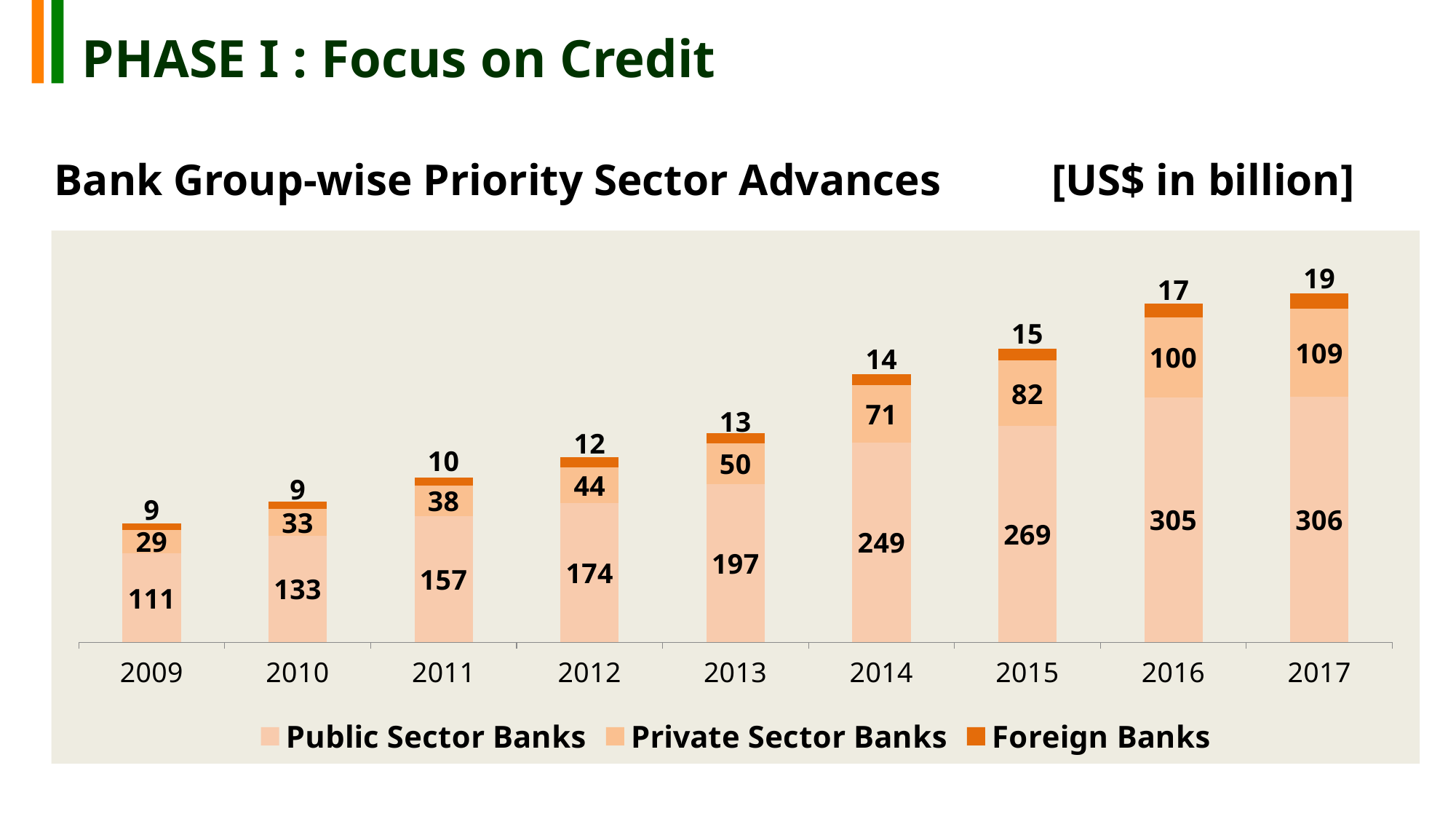
What is the total of the stacked bar for 2009? 149 What kind of chart is shown on the slide? Stacked bar chart What is the difference between the Public Sector Banks values for 2016 and 2009? 194 In which year is the Private Sector Banks value lowest? 2009 Which is larger, the Private Sector Banks value in 2015 or in 2013? 2015 How many series does the legend list? 3 In which year is the Public Sector Banks value highest? 2017 What is the value for Public Sector Banks in 2014? 249 What is the total of the stacked bar for 2017? 434 What is the value for Private Sector Banks in 2012? 44 How many years are shown on the x axis? 9 What is the value for Foreign Banks in 2017? 19